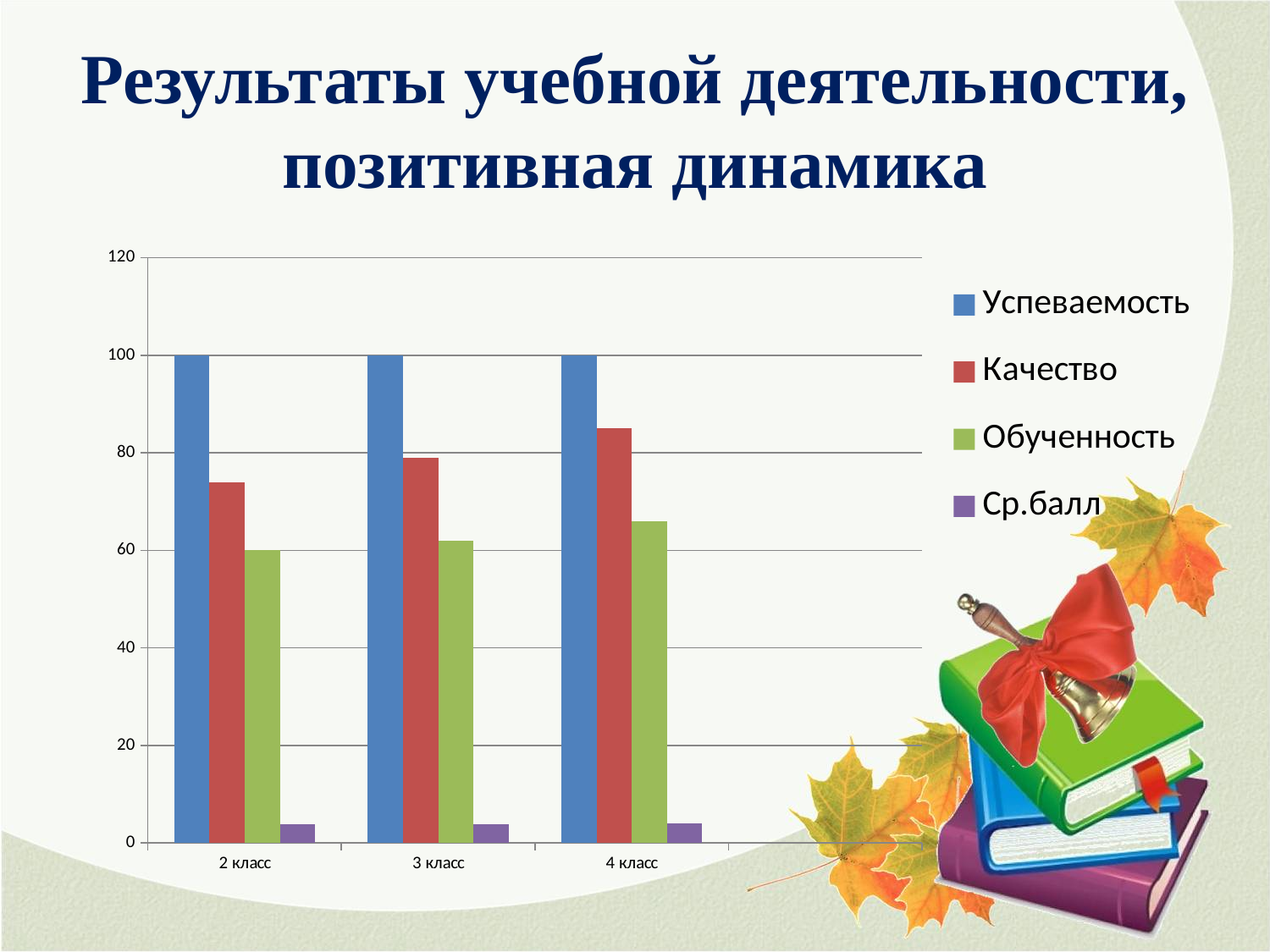
What is the value of Успеваемость for 2 класс? 100 How many series does the legend list? 4 Which series has the lowest value for 2 класс? Ср.балл Is the value of Качество for 2 класс greater or less than 80? less Is the value of Обученность for 4 класс greater or less than 60? greater Is the value of Ср.балл for 3 класс greater or less than 20? less For 3 класс, which is larger: Качество or Обученность? Качество How many categories are shown on the x axis? 3 Does the value of Качество rise or fall from 2 класс to 4 класс? rises What colour represents Качество in the legend? red What kind of chart is shown on the slide? bar chart